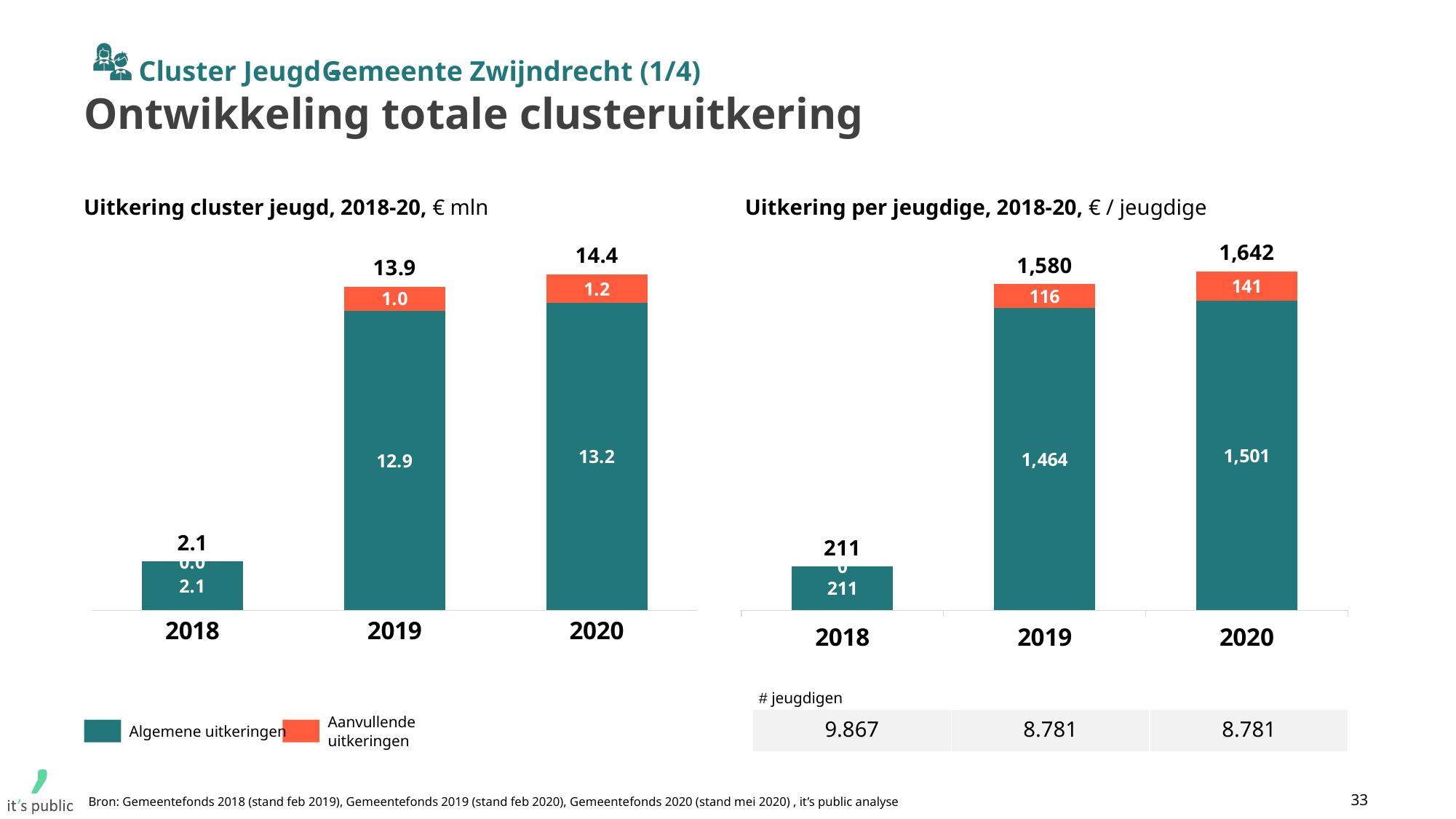
In the chart 'Uitkering per jeugdige, 2018-20', what is the total of the stacked bar for 2019? 1,580 In the chart 'Uitkering per jeugdige, 2018-20', do the totals rise or fall from 2018 to 2020? rise In the chart 'Uitkering per jeugdige, 2018-20', what is the value of Aanvullende uitkeringen for 2019? 116 In the chart 'Uitkering cluster jeugd, 2018-20', what is the difference between the totals for 2020 and 2019? 0.5 In the chart 'Uitkering cluster jeugd, 2018-20', what is the total of the stacked bar for 2020? 14.4 What type of chart is 'Uitkering cluster jeugd, 2018-20'? stacked bar chart In the chart 'Uitkering per jeugdige, 2018-20', which year has the highest total? 2020 In the chart 'Uitkering cluster jeugd, 2018-20', what is the value of Aanvullende uitkeringen for 2020? 1.2 In the chart 'Uitkering cluster jeugd, 2018-20', what is the value of Algemene uitkeringen for 2019? 12.9 In the chart 'Uitkering cluster jeugd, 2018-20', which year has the lowest total? 2018 In the chart 'Uitkering per jeugdige, 2018-20', what is the value of Algemene uitkeringen for 2020? 1,501 How many years are shown on the x axis of the chart 'Uitkering cluster jeugd, 2018-20'? 3